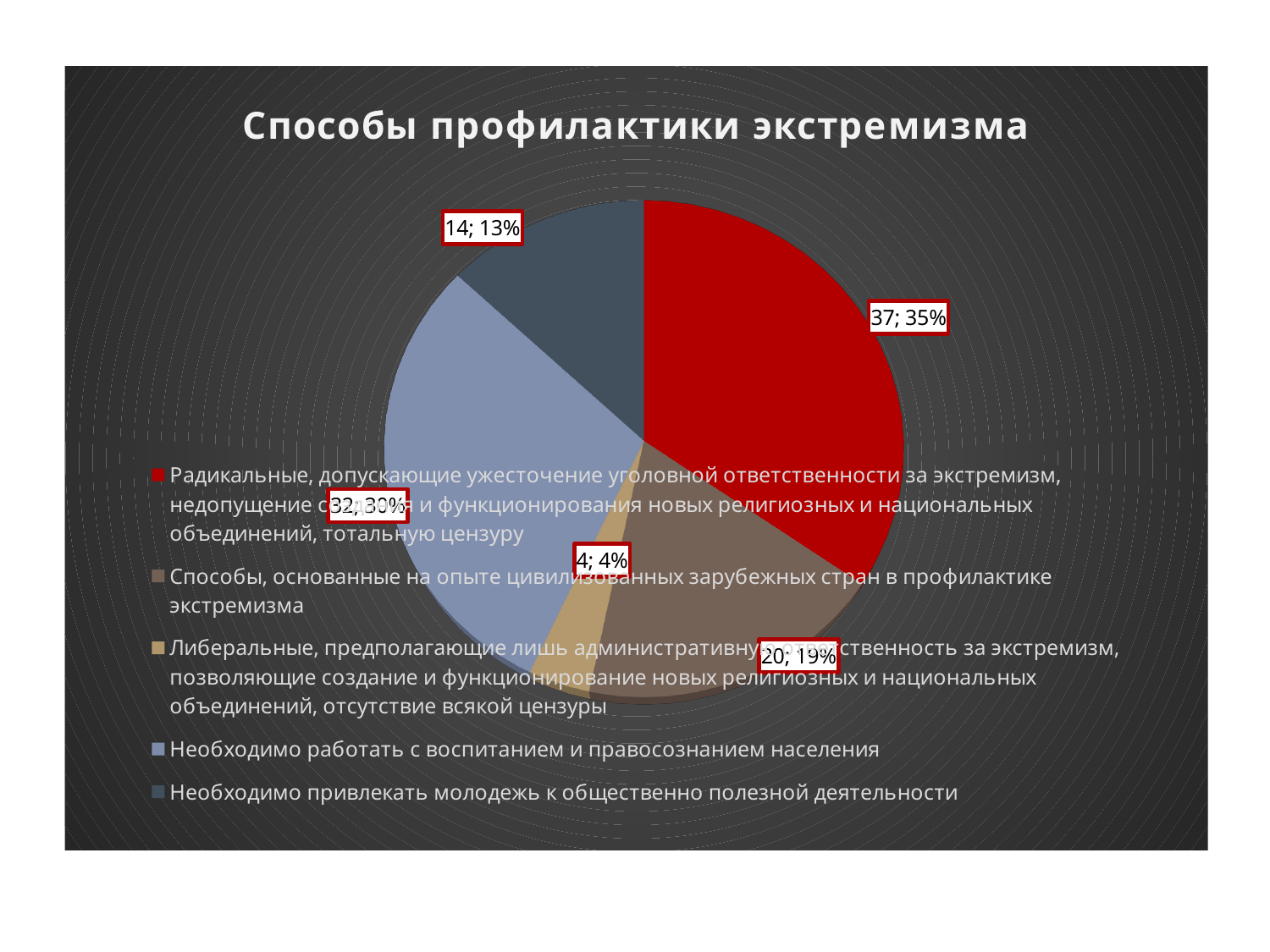
Which slice is the smallest? Либеральные, предполагающие лишь административную ответственность за экстремизм... What share of the pie does the slice 'Либеральные, предполагающие лишь административную ответственность за экстремизм...' represent? 4% What value is shown for the slice 'Способы, основанные на опыте цивилизованных зарубежных стран в профилактике экстремизма'? 20 How many entries does the legend list? 5 What value is shown for the slice 'Радикальные, допускающие ужесточение уголовной ответственности за экстремизм...'? 37 What is the title of the chart? Способы профилактики экстремизма What is the difference between the value for 'Радикальные...' (37) and the value for 'Необходимо работать с воспитанием и правосознанием населения' (32)? 5 What kind of chart is shown on the slide? pie chart How many slices does the pie chart have? 5 What value is shown for the slice 'Необходимо привлекать молодежь к общественно полезной деятельности'? 14 Which slice is the largest? Радикальные, допускающие ужесточение уголовной ответственности за экстремизм... What share of the pie does the slice 'Необходимо работать с воспитанием и правосознанием населения' represent? 30%